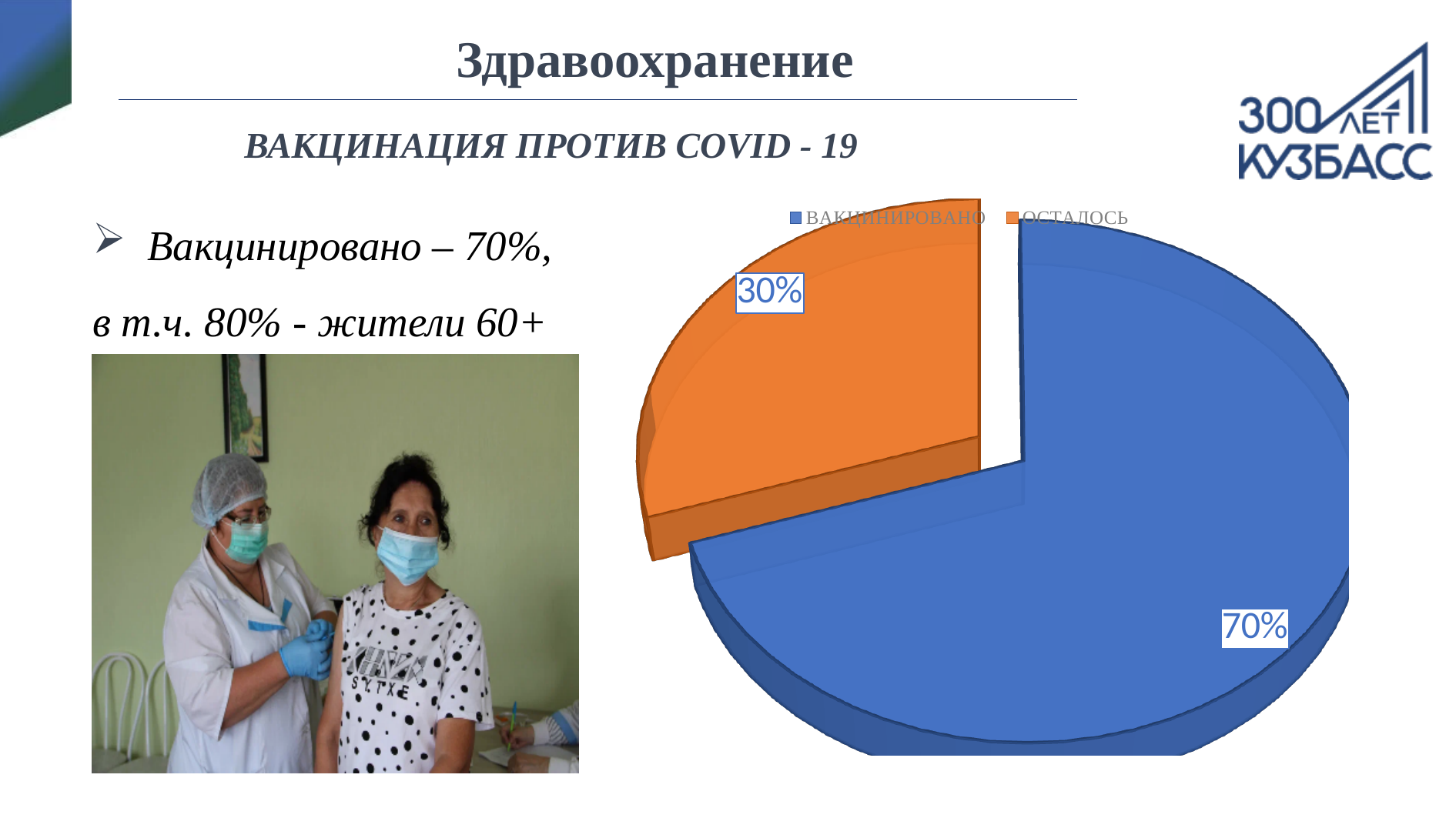
What colour is the ВАКЦИНИРОВАНО slice in the pie chart? blue How many slices does the pie chart have? 2 Which slice of the pie chart is the smallest? ОСТАЛОСЬ What percentage does the ВАКЦИНИРОВАНО slice show? 70% What kind of chart is shown on the slide? pie chart How many entries does the legend of the pie chart list? 2 Which is larger in the pie chart, ВАКЦИНИРОВАНО or ОСТАЛОСЬ? ВАКЦИНИРОВАНО What share of the pie does the ОСТАЛОСЬ slice represent? 30% What colour is the ОСТАЛОСЬ slice in the pie chart? orange Which slice of the pie chart is the largest? ВАКЦИНИРОВАНО What is the difference in percentage points between the ВАКЦИНИРОВАНО and ОСТАЛОСЬ slices? 40 What percentage does the ОСТАЛОСЬ slice show? 30%